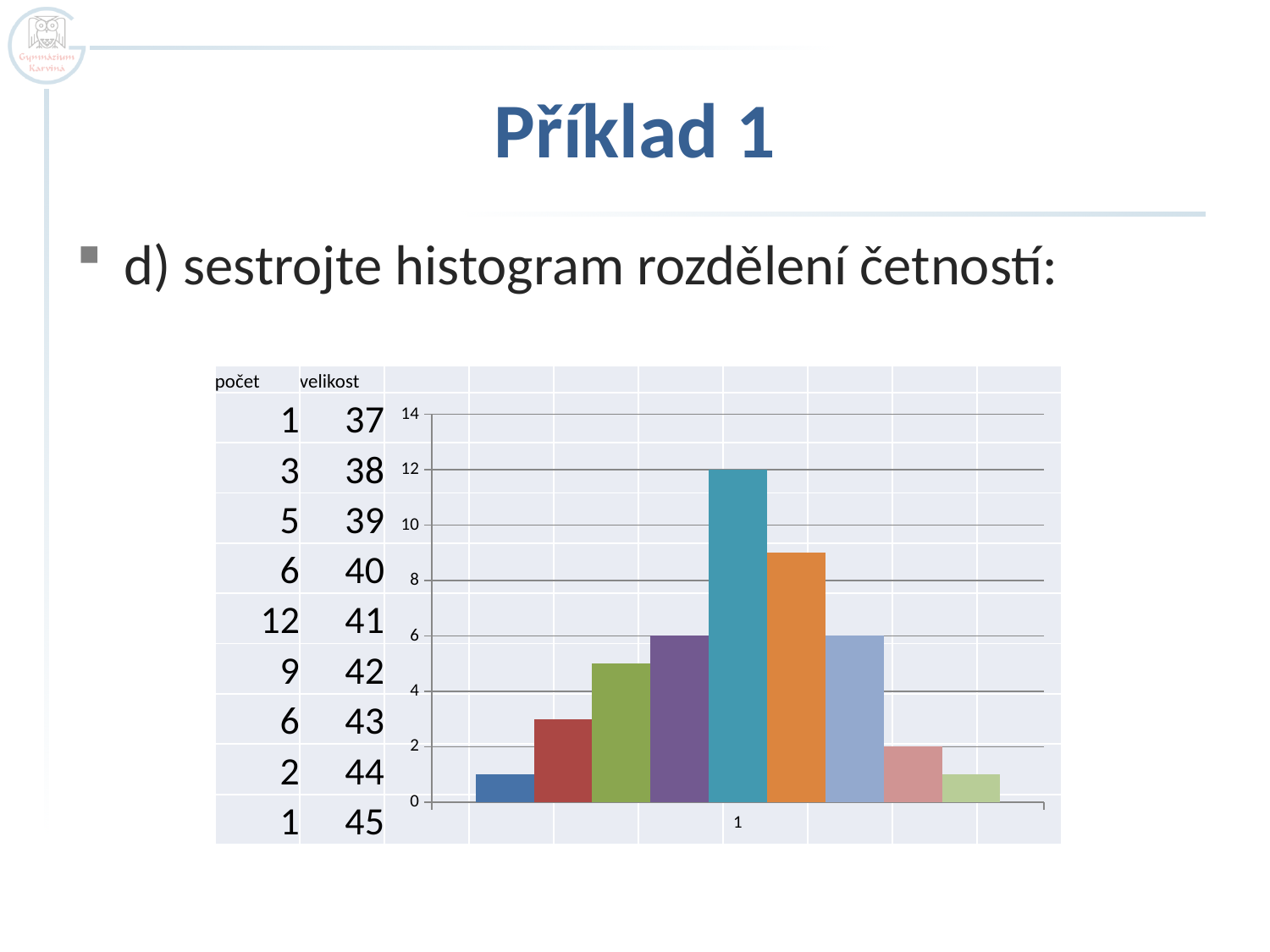
Is the value of the first (dark blue) bar greater or less than 2? less What is the value of the seventh (light blue) bar from the left? 6 What is the difference between the fifth (teal) bar and the seventh (light blue) bar? 6 What is the value of the eighth (pink) bar from the left? 2 Is the value of the third (green) bar greater or less than 6? less What is the value of the tallest bar in the chart? 12 According to the table next to the chart, what is the počet (count) for velikost 41? 12 What is the value of the fifth (teal) bar from the left? 12 Which is taller, the fifth (teal) bar or the sixth (orange) bar? the fifth (teal) bar What kind of chart is shown on the slide? bar chart How many bars are plotted in the chart? 9 Is the value of the sixth (orange) bar greater or less than 8? greater